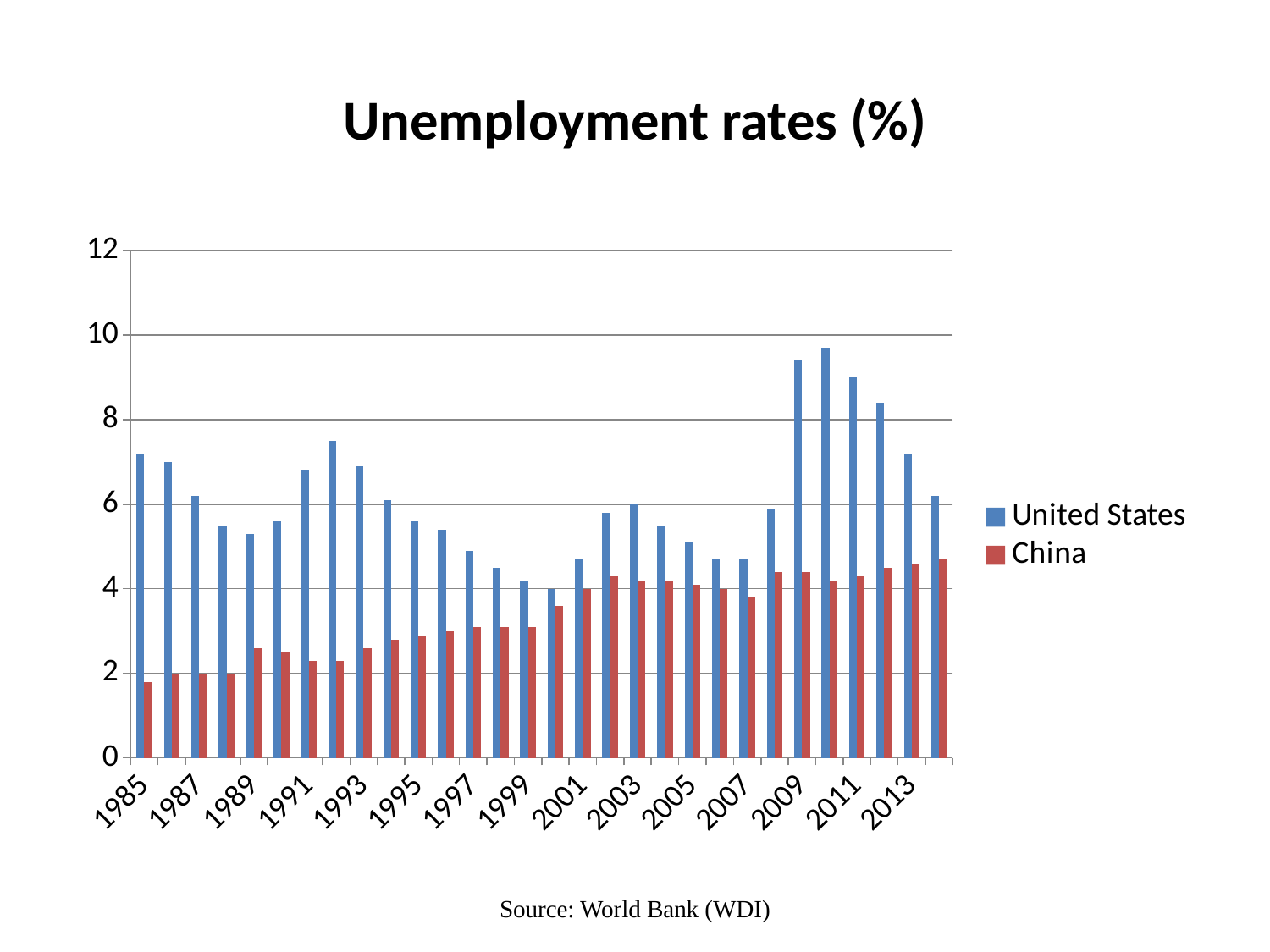
Which series is shown in blue? United States What is the title of the chart? Unemployment rates (%) In which year does the United States series reach its highest value? 2010 Is the value for China in 1985 greater or less than 2? less How many series does the legend list? 2 Do the United States values rise or fall from 2010 to 2013? fall Is the value for United States in 2001 greater or less than 6? less Is the value for United States in 2010 greater or less than 8? greater In 2009, which series has the larger value, United States or China? United States What kind of chart is shown on the slide? bar chart